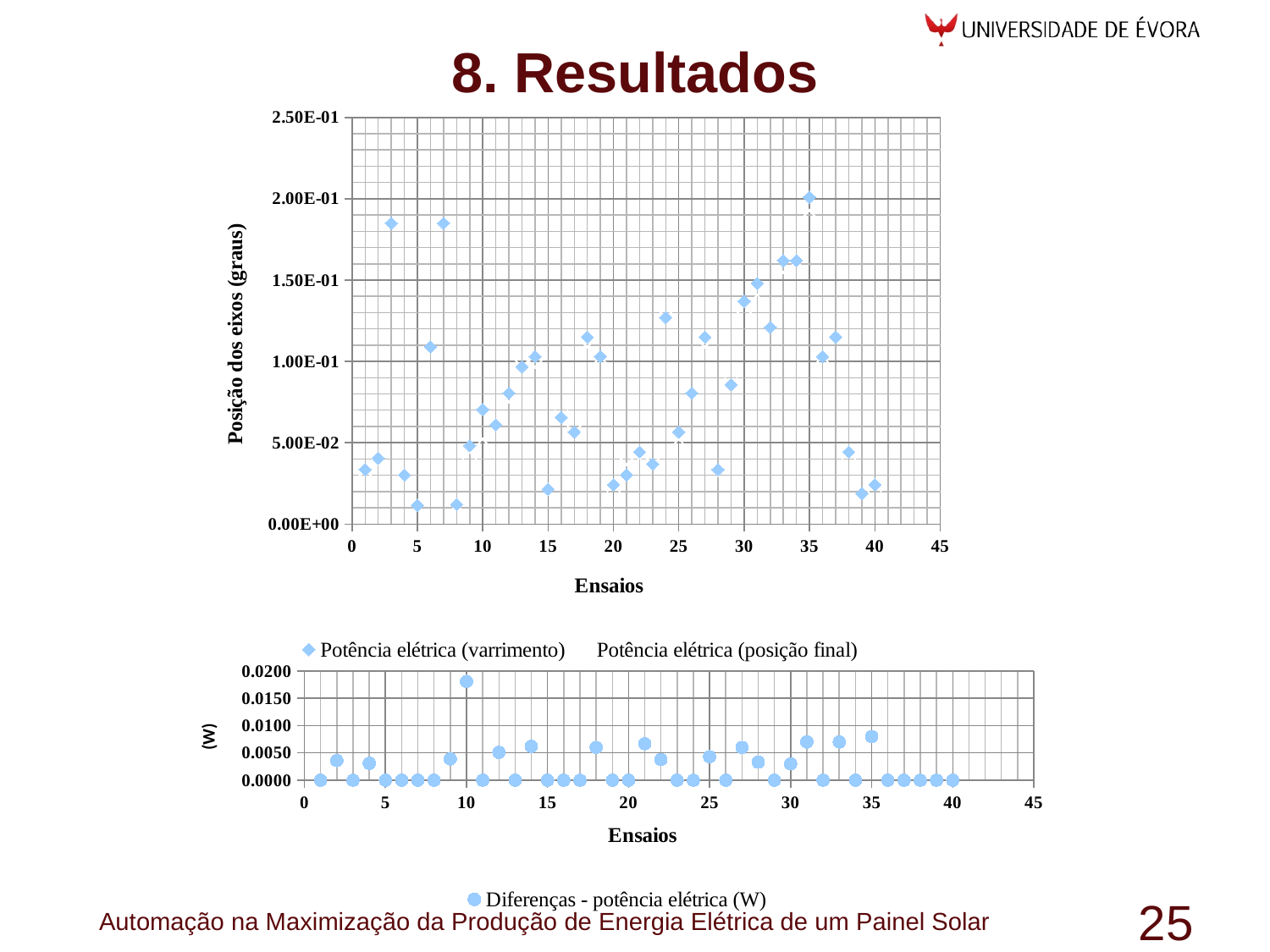
What is the legend entry shown for the bottom chart? Diferenças - potência elétrica (W) In the bottom chart (Diferenças - potência elétrica), at which Ensaio is the plotted value highest? 10 In the top chart (Posição dos eixos), at which Ensaio is the plotted value highest? 35 In the bottom chart (Diferenças - potência elétrica), is the value for Ensaio 35 greater or less than 0.0050? greater In the top chart (Posição dos eixos), is the value for Ensaio 3 greater or less than 1.50E-01? greater In the top chart (Posição dos eixos), which has the larger value, Ensaio 3 or Ensaio 20? Ensaio 3 What kind of chart is the top chart on the slide? Scatter chart In the top chart (Posição dos eixos), is the value for Ensaio 35 greater or less than 1.50E-01? greater In the bottom chart (Diferenças - potência elétrica), which has the larger value, Ensaio 10 or Ensaio 21? Ensaio 10 What is the y-axis title of the top chart? Posição dos eixos (graus)